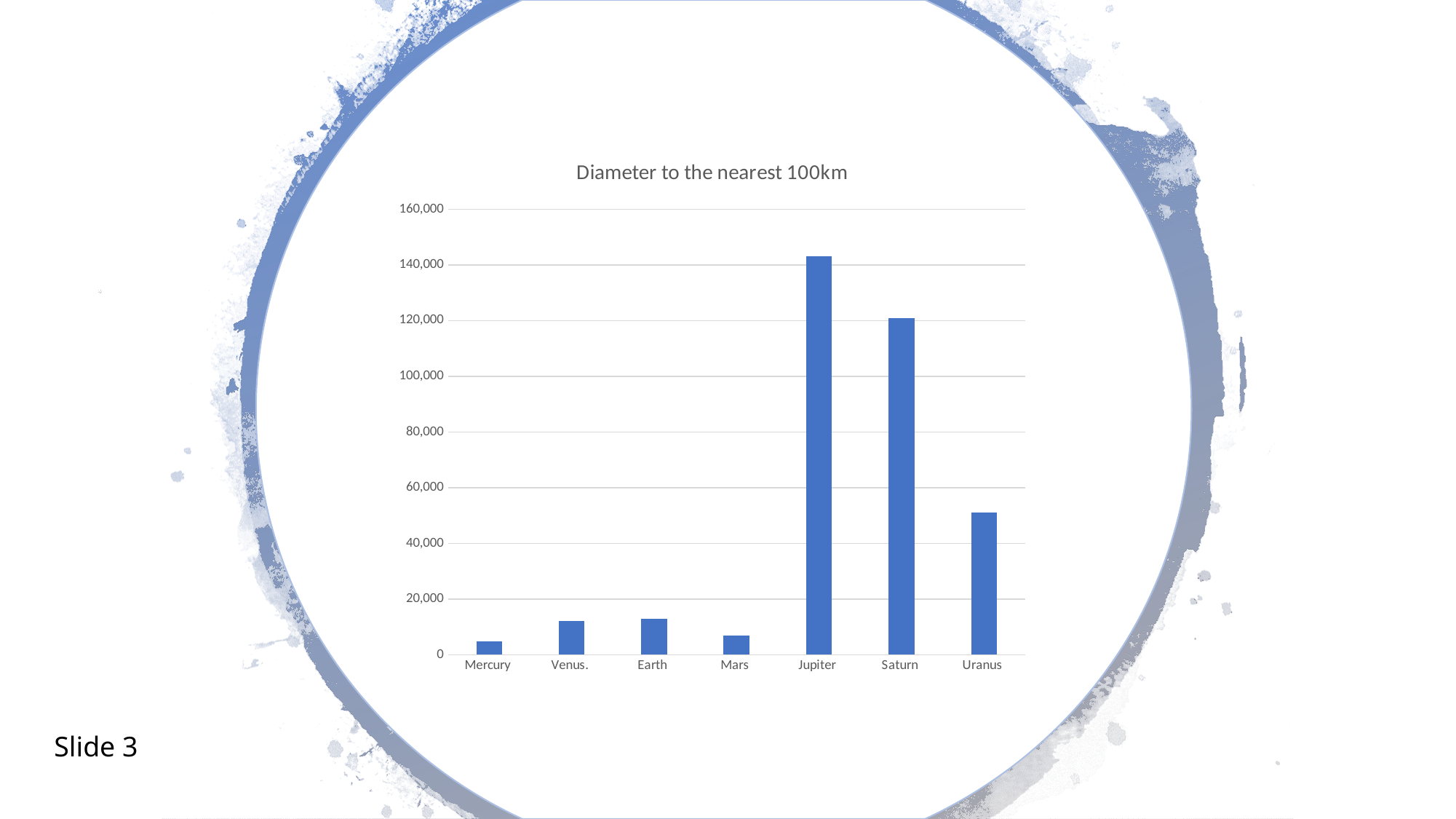
How many planets are plotted on the chart? 7 Which planet has the largest diameter on the chart? Jupiter Which planet is listed first on the x axis? Mercury What is the title of the chart? Diameter to the nearest 100km Which planet has the smallest diameter on the chart? Mercury Is the value for Saturn greater or less than 140,000? less Which has the larger diameter, Jupiter or Saturn? Jupiter What kind of chart is shown on the slide? bar chart Is the value for Earth greater or less than 20,000? less Which has the larger diameter, Uranus or Mars? Uranus Is the value for Uranus greater or less than 40,000? greater